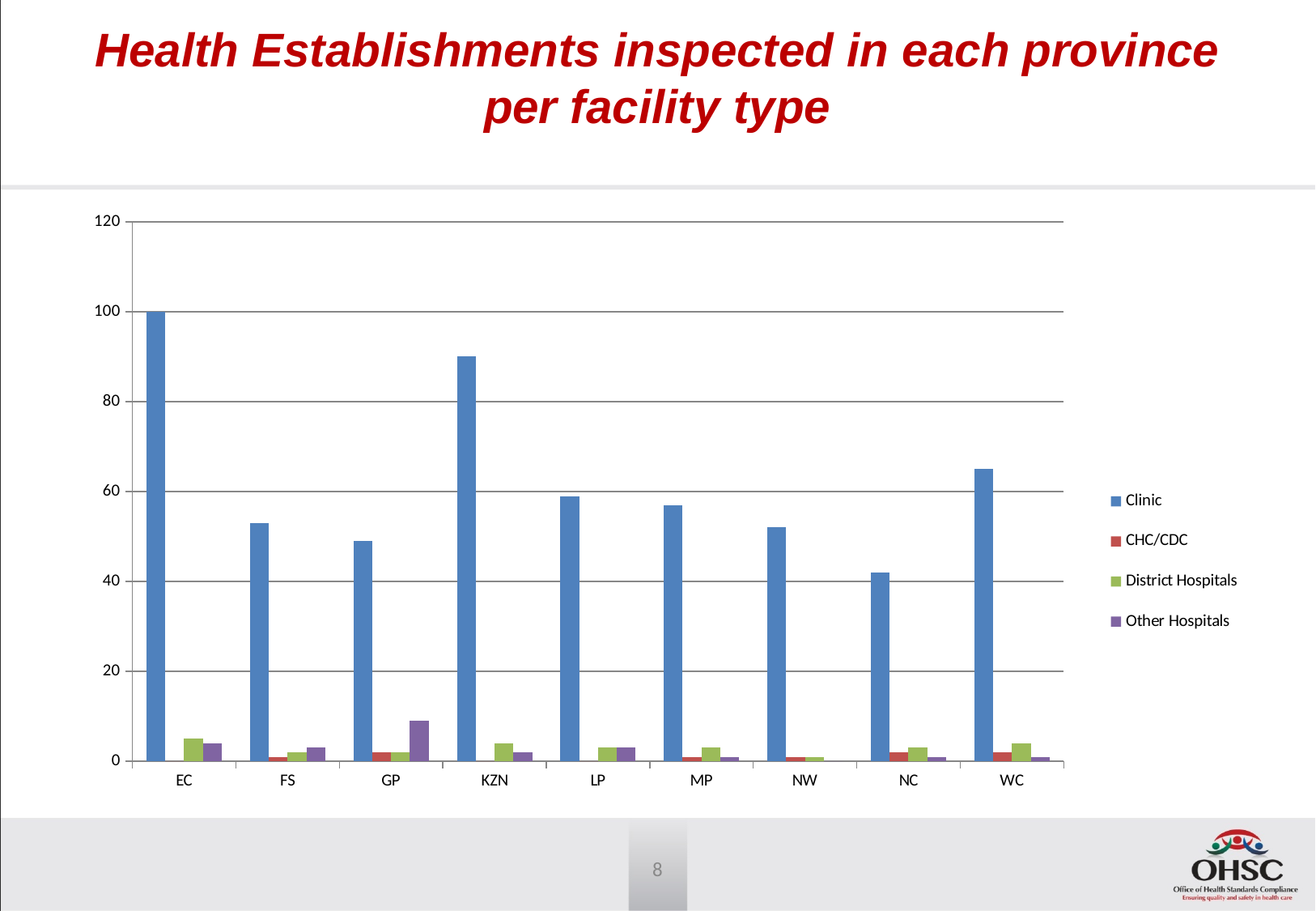
Which series is shown in green in the legend? District Hospitals How many series does the legend list? 4 What is the Clinic value for EC? 100 What kind of chart is shown on the slide? bar chart Which province has the highest Clinic value? EC Which province has the lowest Clinic value? NC Which is larger, the Clinic value for KZN or for WC? KZN Is the Clinic value for FS greater or less than 40? greater How many provinces are shown on the x axis? 9 Which province has the highest Other Hospitals value? GP Is the Clinic value for WC greater or less than 60? greater Is the Clinic value for GP greater or less than 60? less